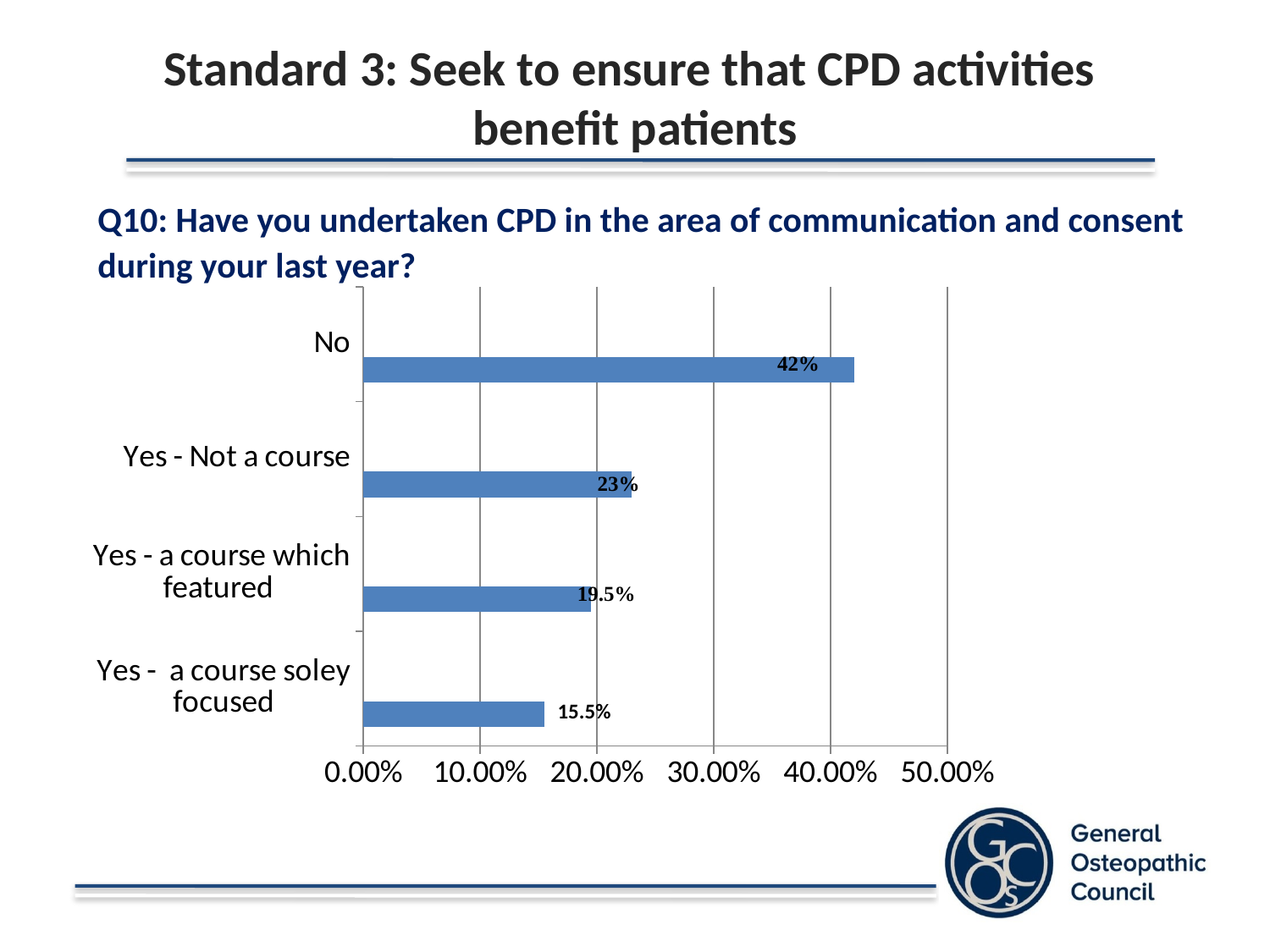
What is the value for "Yes - a course which featured"? 19.5% How many response categories are shown in the chart? 4 What kind of chart is shown on the slide? Bar chart Which response category has the highest value? No What is the difference between the values for "Yes - a course which featured" and "Yes - a course soley focused"? 4% Is the value for "No" greater or less than 40.00%? greater Which response category has the lowest value? Yes - a course soley focused What is the value for "Yes - Not a course"? 23% What percentage of respondents answered "No"? 42% Which is larger: the value for "Yes - Not a course" or "Yes - a course which featured"? Yes - Not a course What is the value for "Yes - a course soley focused"? 15.5% What is the difference between the values for "No" and "Yes - Not a course"? 19%